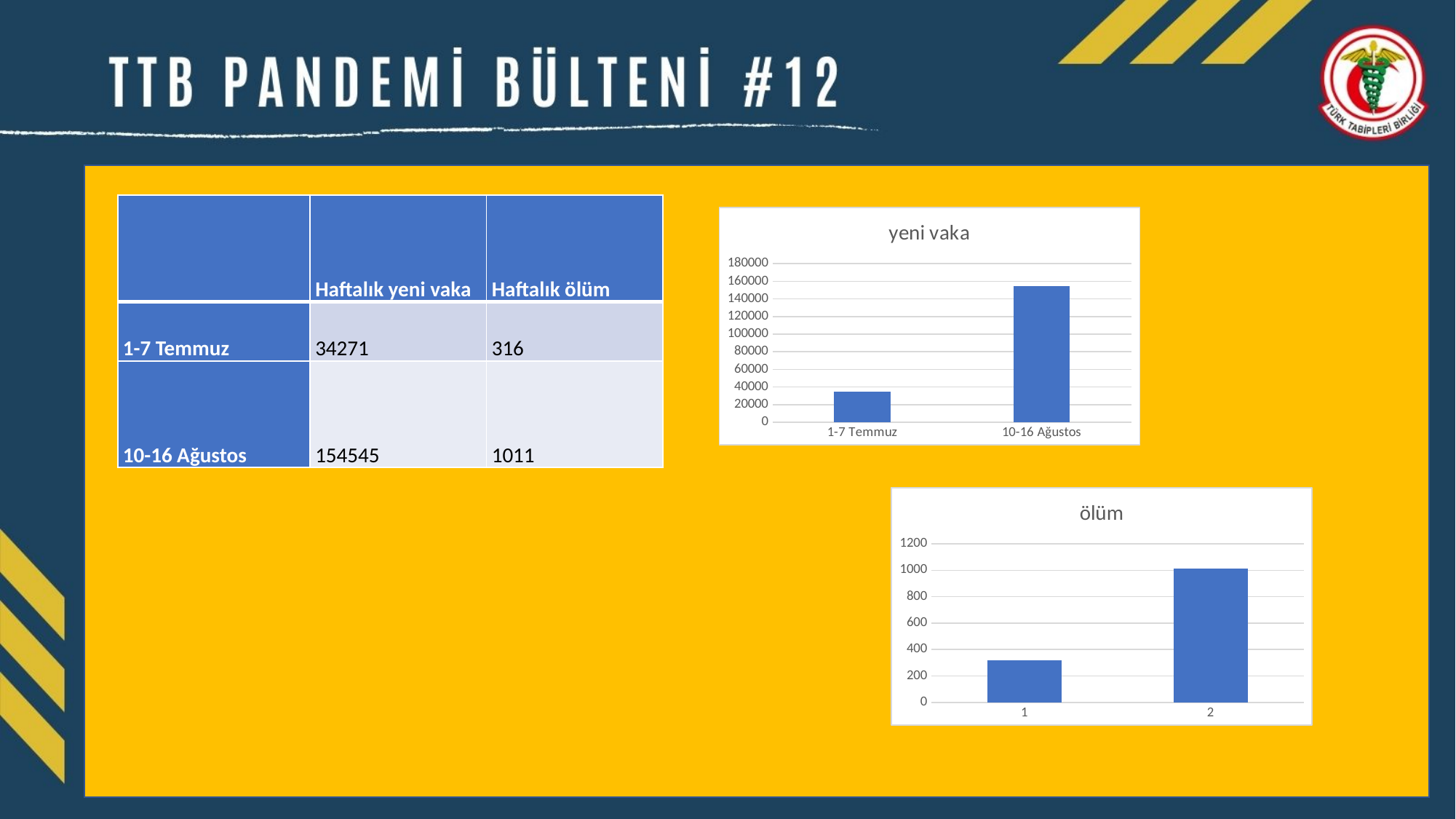
What is the highest tick on the vertical axis of the "ölüm" chart? 1200 In the "ölüm" chart, is the value for category 1 greater or less than 400? less Do the values in the "ölüm" chart rise or fall from left to right? rise In the "yeni vaka" chart, which category has the lowest value? 1-7 Temmuz What kind of chart is the "yeni vaka" chart? bar chart In the "yeni vaka" chart, which category has the highest value? 10-16 Ağustos In the "yeni vaka" chart, is the value for 1-7 Temmuz greater or less than 40000? less How many bars are in the "yeni vaka" chart? 2 What is the title of the chart in the upper right of the slide? yeni vaka In the "yeni vaka" chart, is the value for 10-16 Ağustos greater or less than 140000? greater In the "ölüm" chart, which category has the higher value, 1 or 2? 2